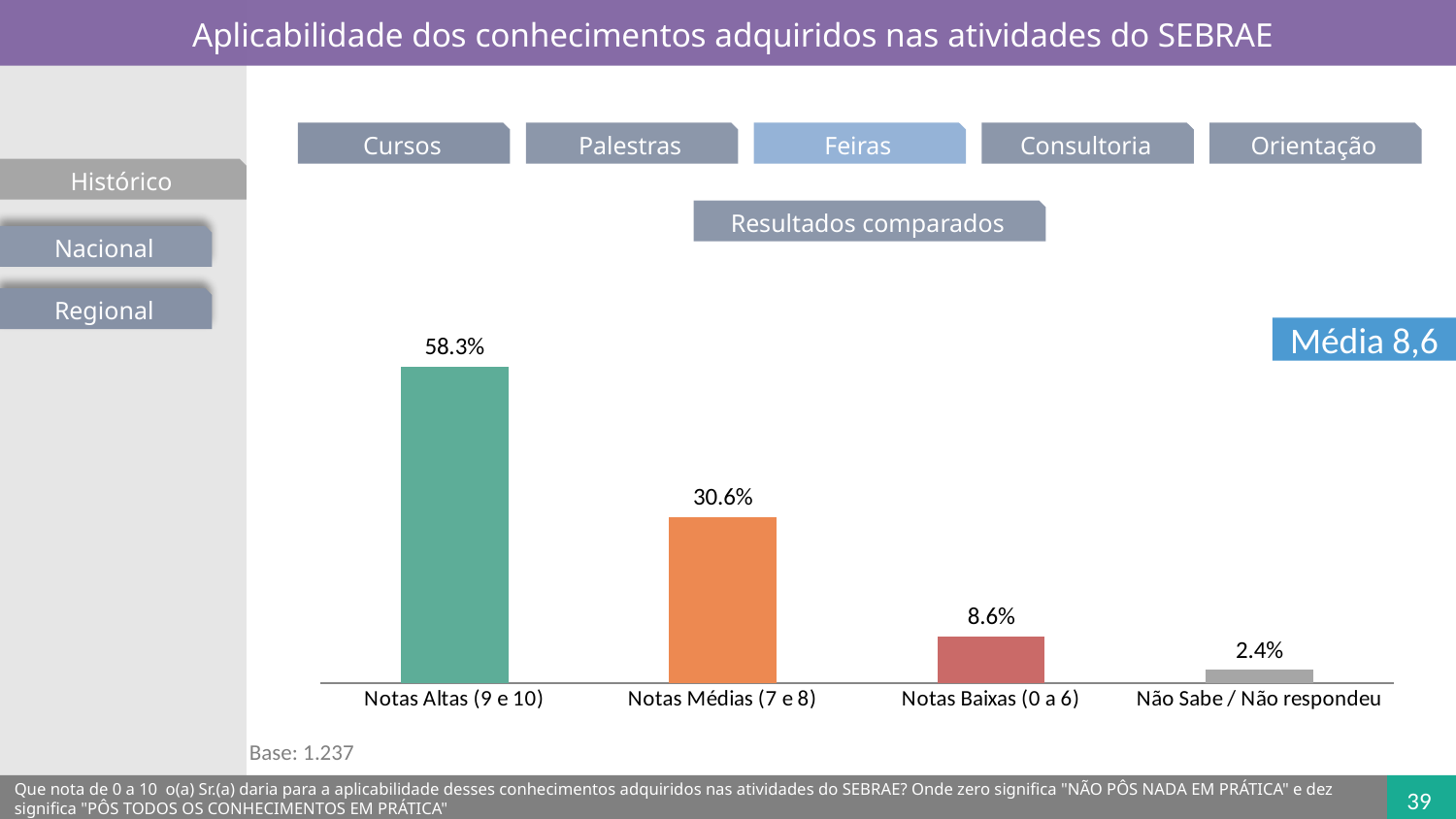
Which category has the highest value? Notas Altas (9 e 10) What is the value for Notas Baixas (0 a 6)? 8.6% Which is larger, Notas Baixas (0 a 6) or Não Sabe / Não respondeu? Notas Baixas (0 a 6) How many categories are shown in the chart? 4 Which category has the lowest value? Não Sabe / Não respondeu What is the difference between Notas Altas (9 e 10) and Notas Médias (7 e 8)? 27.7% What average (Média) is shown on the slide? 8,6 Do the values rise or fall from left to right along the x axis? Fall What is the value for Notas Altas (9 e 10)? 58.3% What kind of chart is shown on the slide? Bar chart What is the value for Não Sabe / Não respondeu? 2.4% What is the value for Notas Médias (7 e 8)? 30.6%